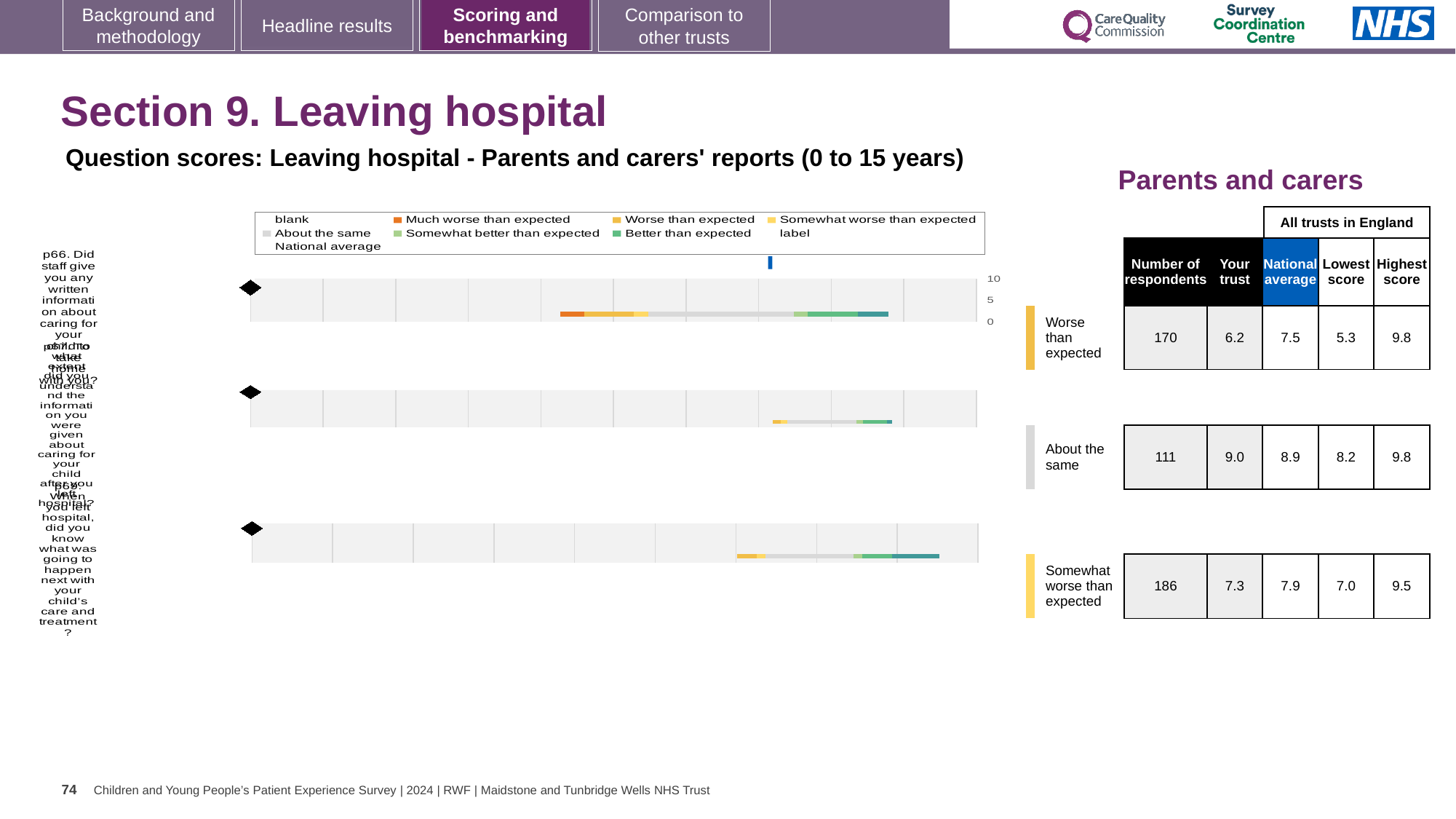
In the table, which of the three questions has the lowest 'Your trust' score? Worse than expected In the table, which of the three questions has the highest 'Your trust' score? About the same In the table, how many respondents answered the question rated 'Somewhat worse than expected'? 186 What is the highest value shown on the chart's axis? 10 In the table, what is the highest score across all trusts in England for the question rated 'Somewhat worse than expected'? 9.5 In the table, what is the national average for the question rated 'About the same'? 8.9 Which legend entry is shown in dark orange? Much worse than expected How many horizontal bars are plotted in the chart? 3 In the table, is the trust score for the 'About the same' question larger or smaller than its national average? larger In the table, what is the 'Your trust' score for the question rated 'Worse than expected'? 6.2 In the table, what is the difference between the national average and the trust score for the question rated 'Worse than expected'? 1.3 What kind of chart is shown on the slide? bar chart